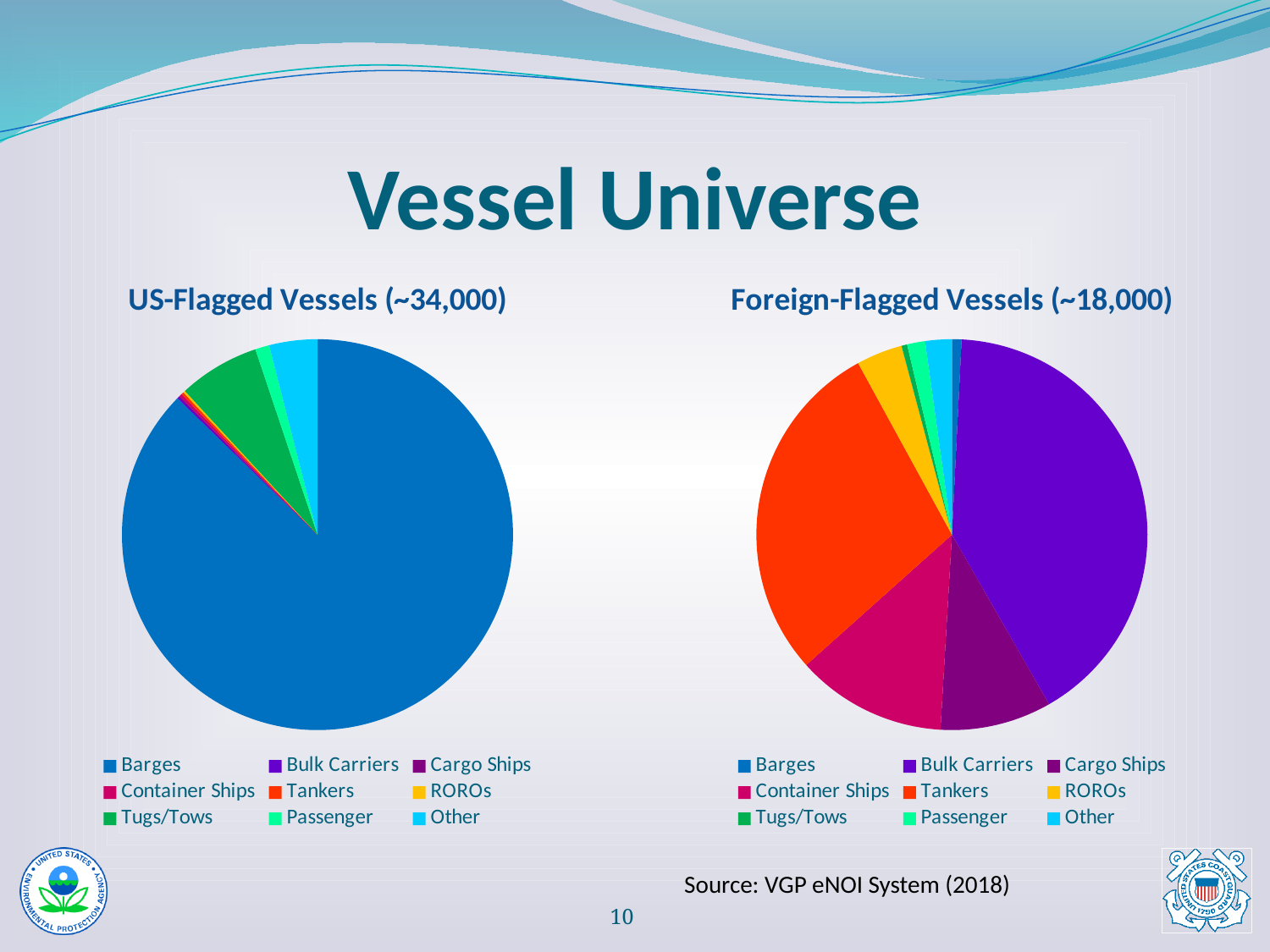
In the Foreign-Flagged Vessels chart, which slice is larger: Bulk Carriers or Tankers? Bulk Carriers In the Foreign-Flagged Vessels chart, which slice is larger: Tankers or Cargo Ships? Tankers How many categories does the legend of the US-Flagged Vessels chart list? 9 What kind of chart is the US-Flagged Vessels chart? Pie chart In the Foreign-Flagged Vessels chart, which slice is larger: Container Ships or ROROs? Container Ships In the US-Flagged Vessels chart, which category has the largest slice? Barges What approximate total number of vessels is given in the title of the Foreign-Flagged Vessels chart? ~18,000 How many categories does the legend of the Foreign-Flagged Vessels chart list? 9 In the Foreign-Flagged Vessels chart, which category has the largest slice? Bulk Carriers What kind of chart is the Foreign-Flagged Vessels chart? Pie chart What approximate total number of vessels is given in the title of the US-Flagged Vessels chart? ~34,000